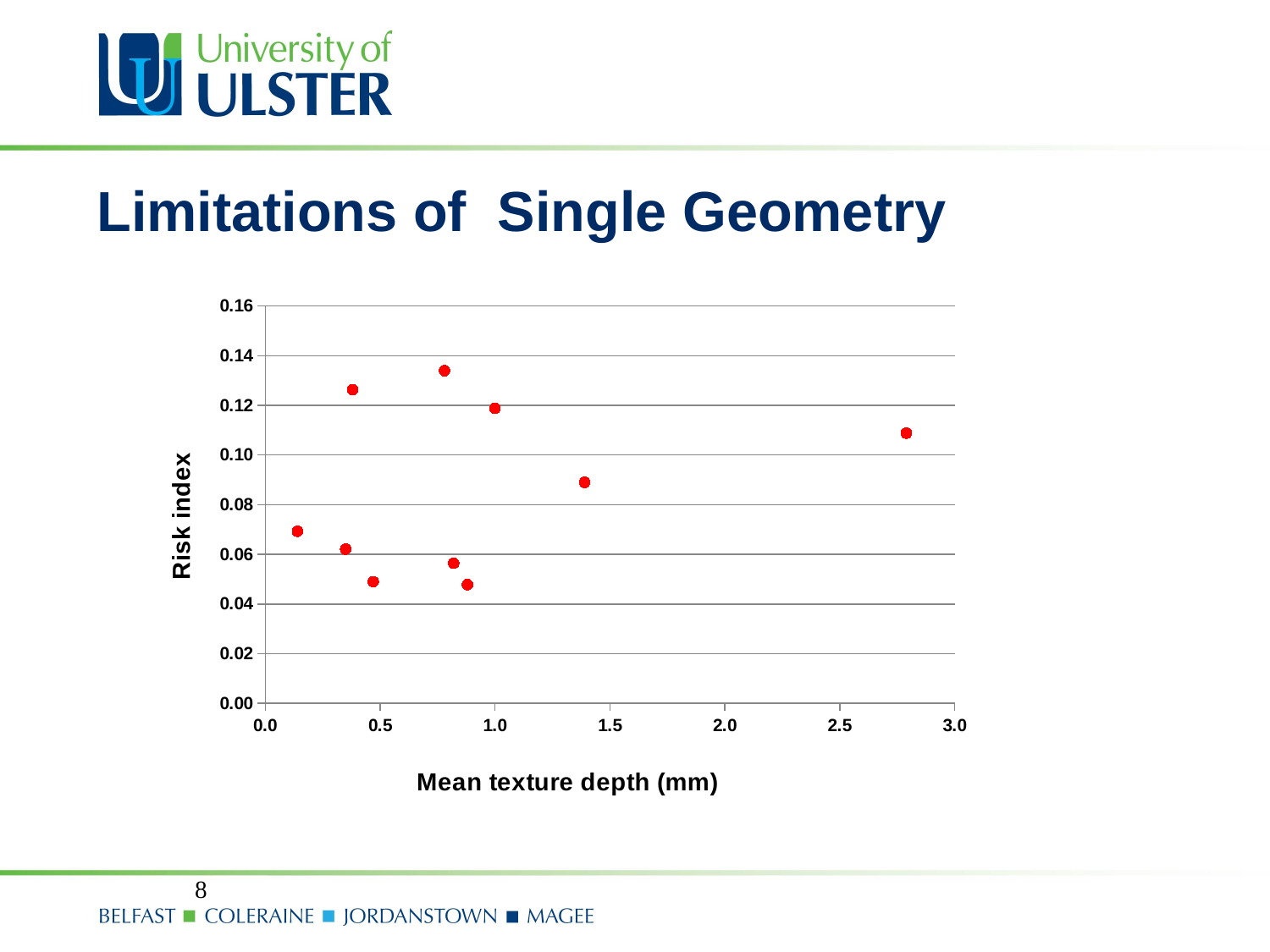
Which has the larger risk index: the point near 1.4 mm or the point near 2.8 mm mean texture depth? the point near 2.8 mm Is the risk index of the point near 1.0 mm mean texture depth greater or less than 0.10? greater How many points have a risk index above 0.10? 4 Is the risk index of the point near 1.4 mm mean texture depth greater or less than 0.10? less What kind of chart is shown on the slide? scatter plot What is the label of the y axis? Risk index How many data points are plotted on the chart? 10 What is the label of the x axis? Mean texture depth (mm) Is the risk index of the highest point on the chart greater or less than 0.12? greater